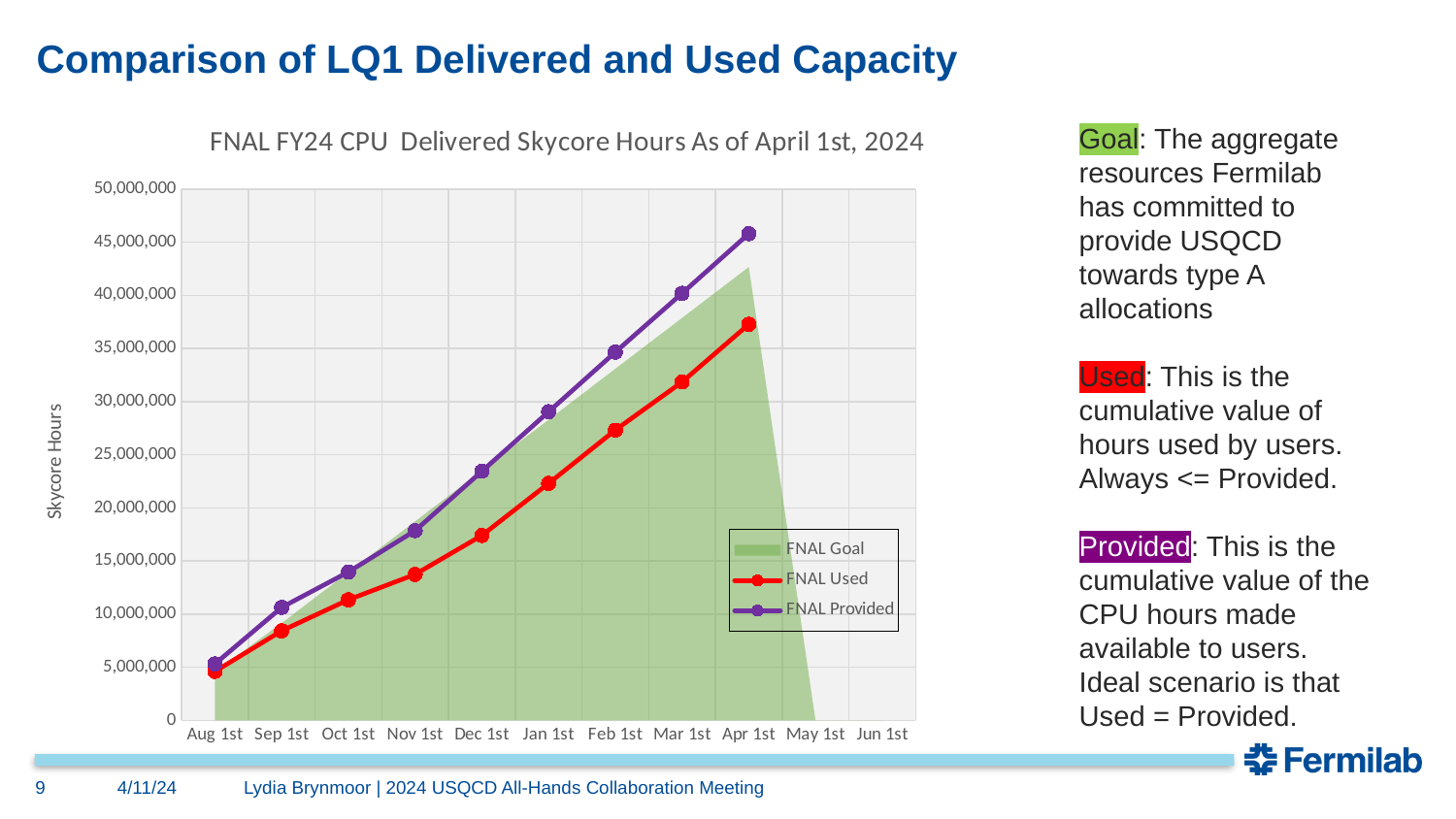
Is the FNAL Provided value at Dec 1st greater or less than 20,000,000? greater How many series does the chart legend list? 3 At Apr 1st, which is larger: FNAL Provided or FNAL Used? FNAL Provided At which x-axis date does the FNAL Provided line reach its highest value? Apr 1st What is the title of the chart? FNAL FY24 CPU Delivered Skycore Hours As of April 1st, 2024 What are the three series named in the legend? FNAL Goal, FNAL Used, FNAL Provided Do the FNAL Provided values rise or fall from Aug 1st to Apr 1st? rise Is the FNAL Provided value at Apr 1st greater or less than 45,000,000? greater How many categories are shown on the x axis? 11 Is the FNAL Used value at Feb 1st greater or less than 25,000,000? greater How many data points are plotted on the FNAL Used line? 9